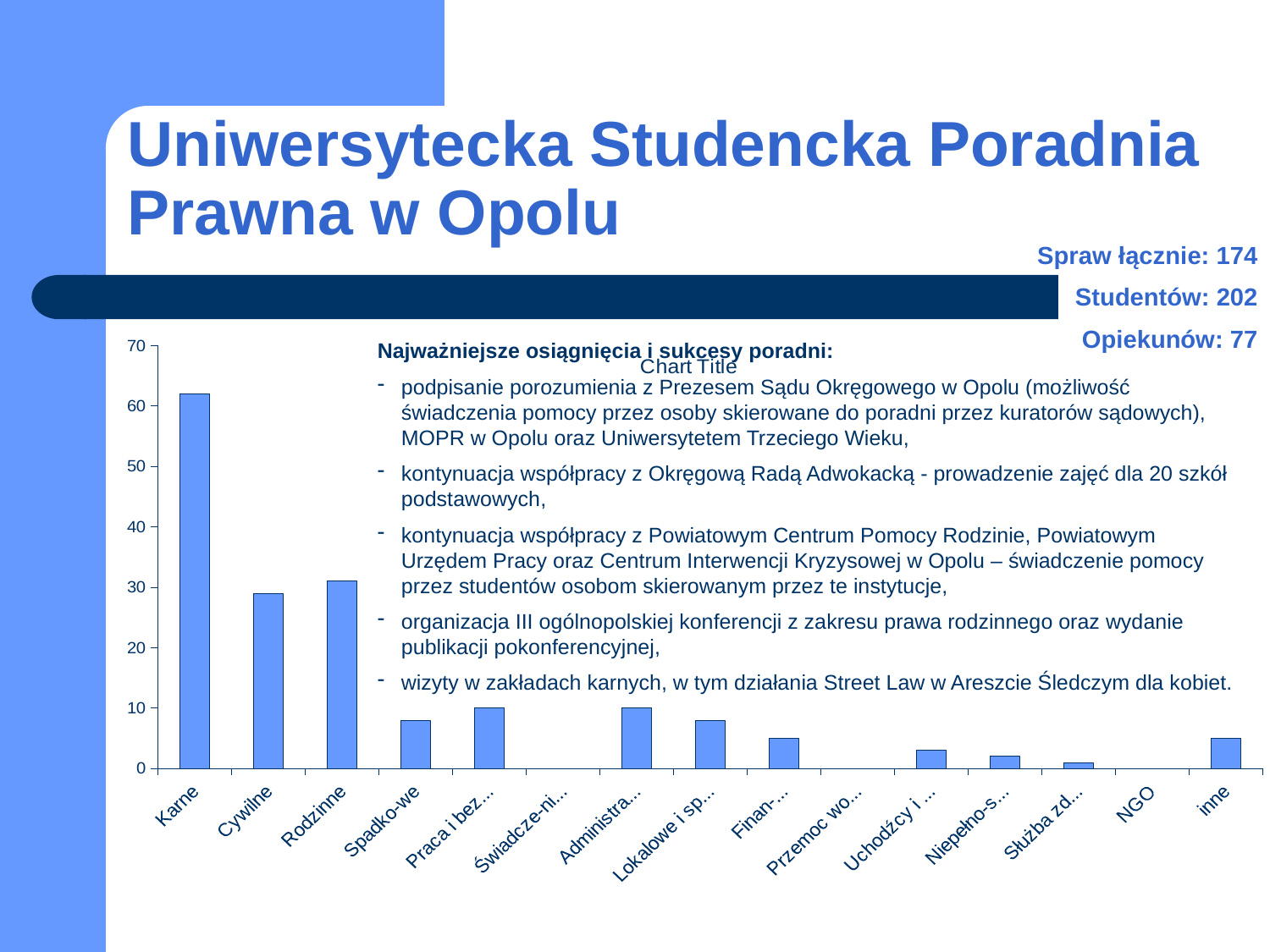
Which category has the highest value in the chart? Karne Is the value for Rodzinne greater or less than 20? greater What kind of chart is shown on the slide? bar chart Which is larger, the value for Karne or the value for Cywilne? Karne Is the value for Finan-... greater or less than 10? less Is the value for Karne greater or less than 50? greater What is the title shown above the chart? Chart Title How many categories are shown on the x axis of the chart? 15 Which is larger, the value for Rodzinne or the value for Spadko-we? Rodzinne